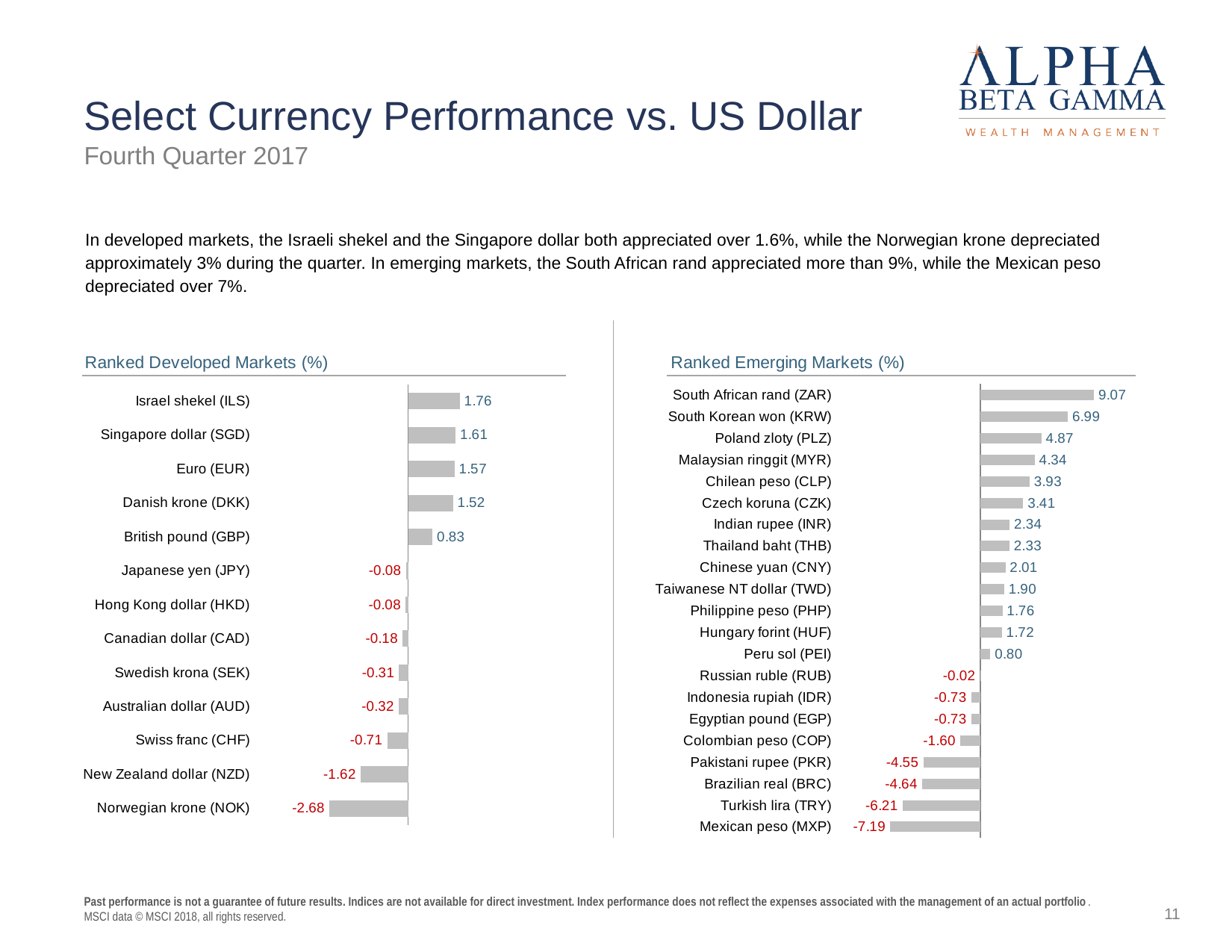
In the Ranked Emerging Markets (%) chart, what is the value for the Chilean peso (CLP)? 3.93 In the Ranked Emerging Markets (%) chart, which currency has the lowest value? Mexican peso (MXP) How many currencies are shown in the Ranked Emerging Markets (%) chart? 21 In the Ranked Emerging Markets (%) chart, what is the value for the Turkish lira (TRY)? -6.21 In the Ranked Emerging Markets (%) chart, which is larger, the value for the Indian rupee (INR) or the Thailand baht (THB)? Indian rupee (INR) In the Ranked Developed Markets (%) chart, which currency has the highest value? Israel shekel (ILS) In the Ranked Developed Markets (%) chart, what is the value for the British pound (GBP)? 0.83 In the Ranked Emerging Markets (%) chart, what is the difference between the South African rand (ZAR) and the South Korean won (KRW)? 2.08 What kind of chart is the Ranked Emerging Markets (%) chart? Bar chart In the Ranked Developed Markets (%) chart, what is the value for the Euro (EUR)? 1.57 How many currencies are shown in the Ranked Developed Markets (%) chart? 13 In the Ranked Developed Markets (%) chart, what is the difference between the Israel shekel (ILS) and the Norwegian krone (NOK)? 4.44